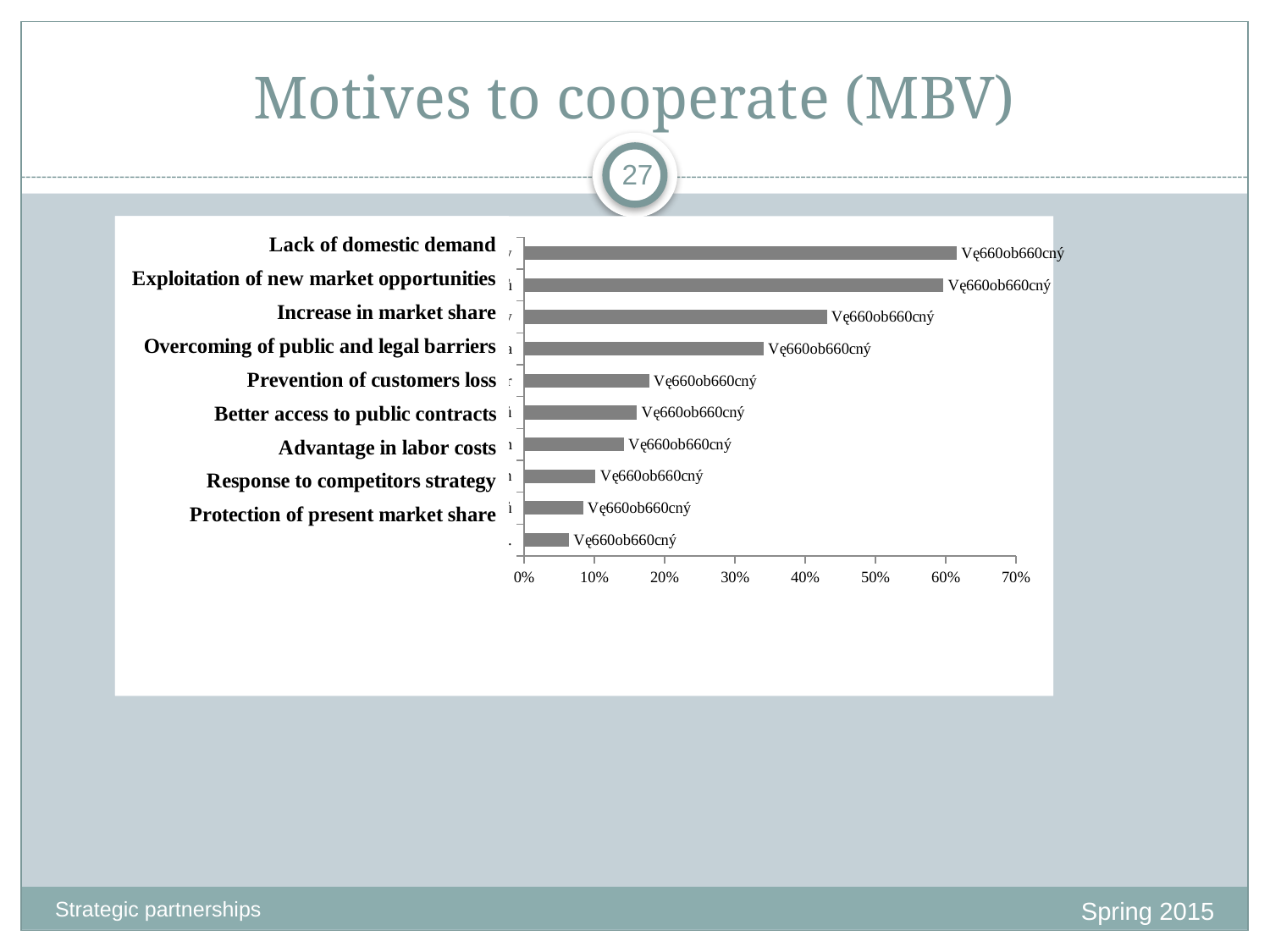
What is the title of the slide containing the chart? Motives to cooperate (MBV) What kind of chart is shown on the slide? bar chart Is the value for Overcoming of public and legal barriers greater or less than 40%? less Which motive has the highest value in the chart? Lack of domestic demand Is the value for Prevention of customers loss greater or less than 20%? less Which is larger, the value for Increase in market share or the value for Better access to public contracts? Increase in market share Is the value for Protection of present market share greater or less than 10%? less Do the bar values rise or fall going from the top of the chart to the bottom? fall How many bars are plotted in the chart? 10